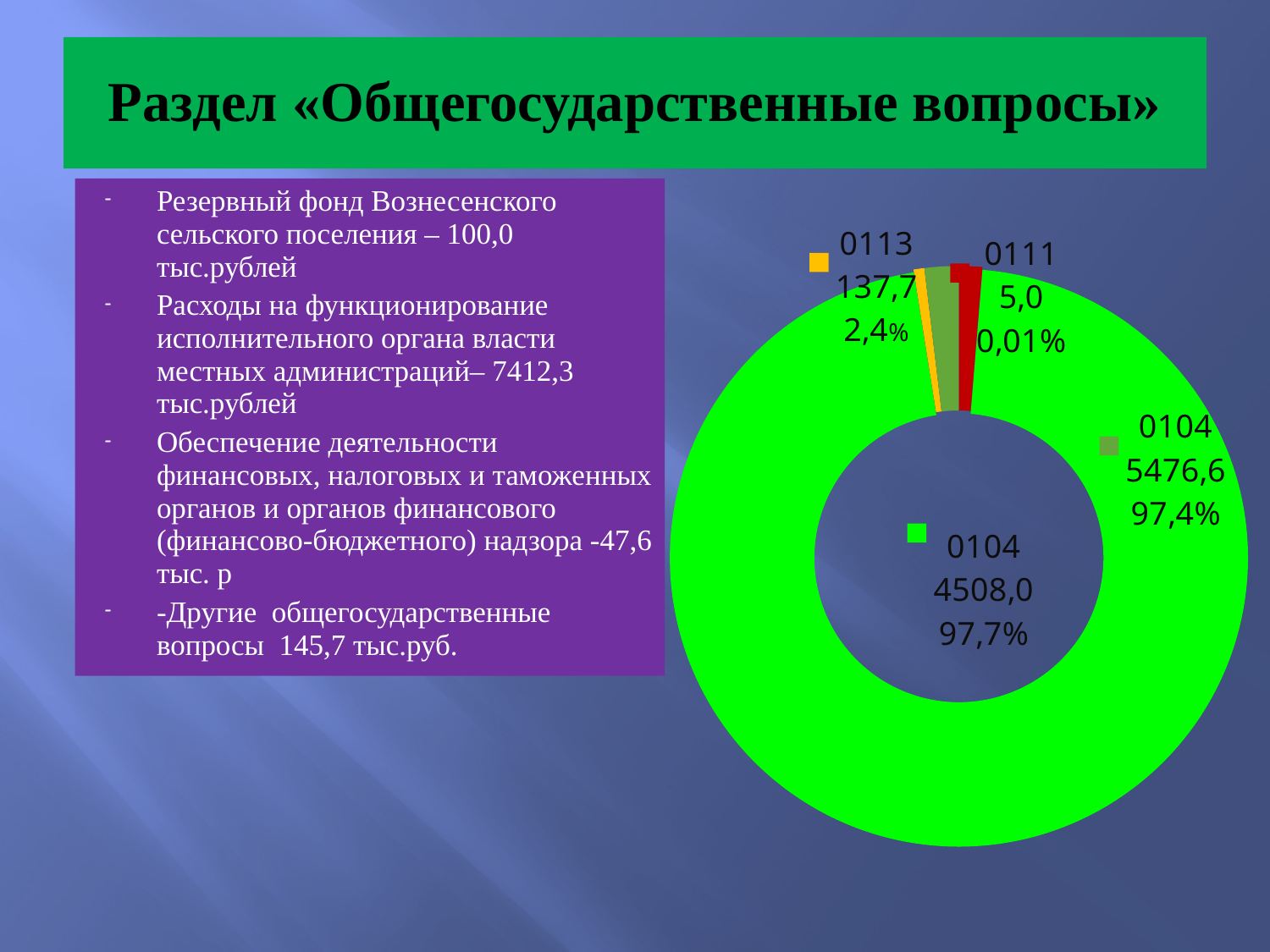
What is the title of the slide containing the chart? Раздел «Общегосударственные вопросы» What percentage share is shown for category 0113? 2,4% What percentage share is shown for category 0111? 0,01% Which is larger, the value for 0113 or the value for 0111? 0113 What percentage is shown next to the label 0104 with the value 5476,6? 97,4% Which category takes up the largest part of the chart? 0104 What is the difference between the value for 0113 and the value for 0111? 132,7 What kind of chart is shown on the slide? Doughnut (pie) chart What value is shown for category 0111 on the chart? 5,0 What value is shown for category 0113 on the chart? 137,7 What value is shown next to the label 0104 with the share 97,7%? 4508,0